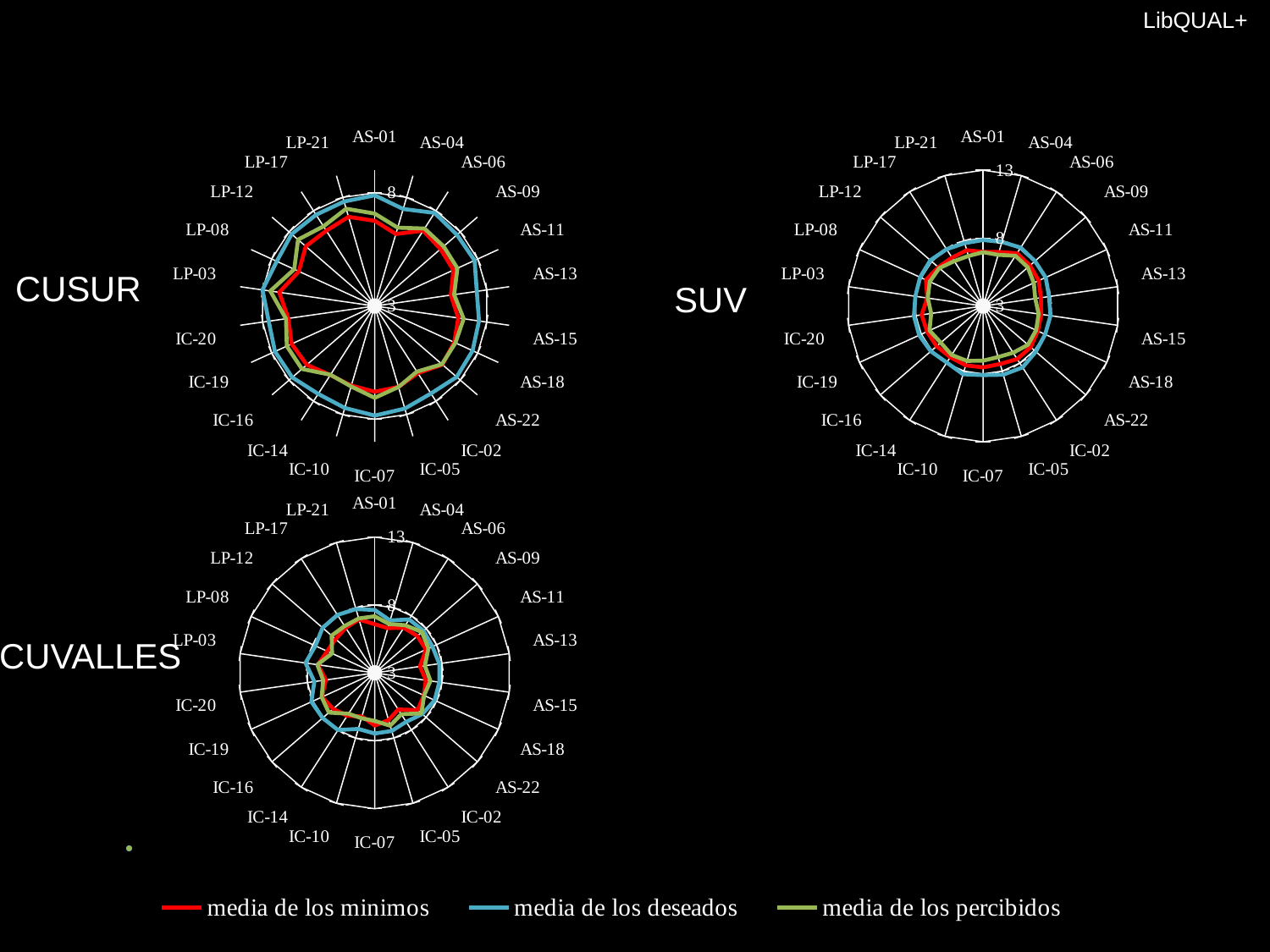
In the CUSUR chart, which is larger at AS-15: media de los deseados or media de los minimos? media de los deseados In the CUSUR chart, which series forms the outermost line? media de los deseados How many series does the legend at the bottom of the slide list? 3 Which series is drawn in red in the legend? media de los minimos How many radar charts are shown on the slide? 3 In the CUVALLES chart, is the value for media de los minimos at IC-07 greater or less than 8? less How many categories are plotted around the SUV radar chart? 22 In the CUSUR chart, is the value for media de los deseados at AS-01 greater or less than 3? greater In the CUVALLES chart, which series forms the outermost line? media de los deseados In the SUV chart, is the value for media de los deseados at AS-13 greater or less than 13? less What kind of chart is the CUSUR chart? radar chart What is the highest axis tick value shown on the CUVALLES chart? 13